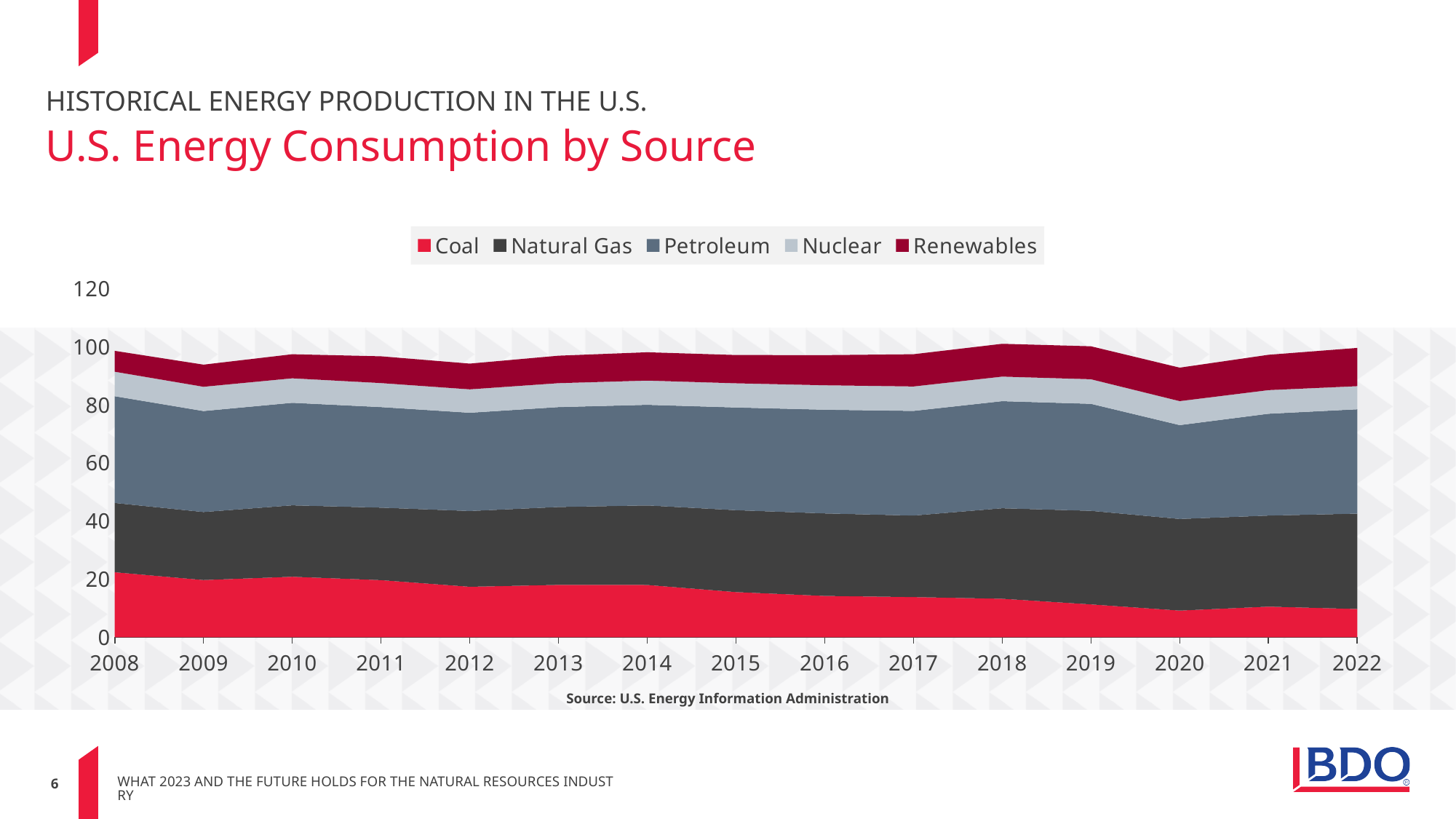
How many years are shown along the x axis? 15 How many series does the legend list? 5 Which is larger, the Coal value in 2008 or the Coal value in 2022? 2008 What source is cited below the chart? U.S. Energy Information Administration Is the value for Coal in 2008 greater or less than 20? greater Which year is the first on the x axis? 2008 Does the Coal series rise or fall from 2008 to 2022? Fall What kind of chart is shown on the slide? Stacked area chart Which series is listed first in the legend? Coal Which year is the last on the x axis? 2022 Is the value for Coal in 2022 greater or less than 20? less Does the Renewables band get thicker or thinner from 2008 to 2022? Thicker